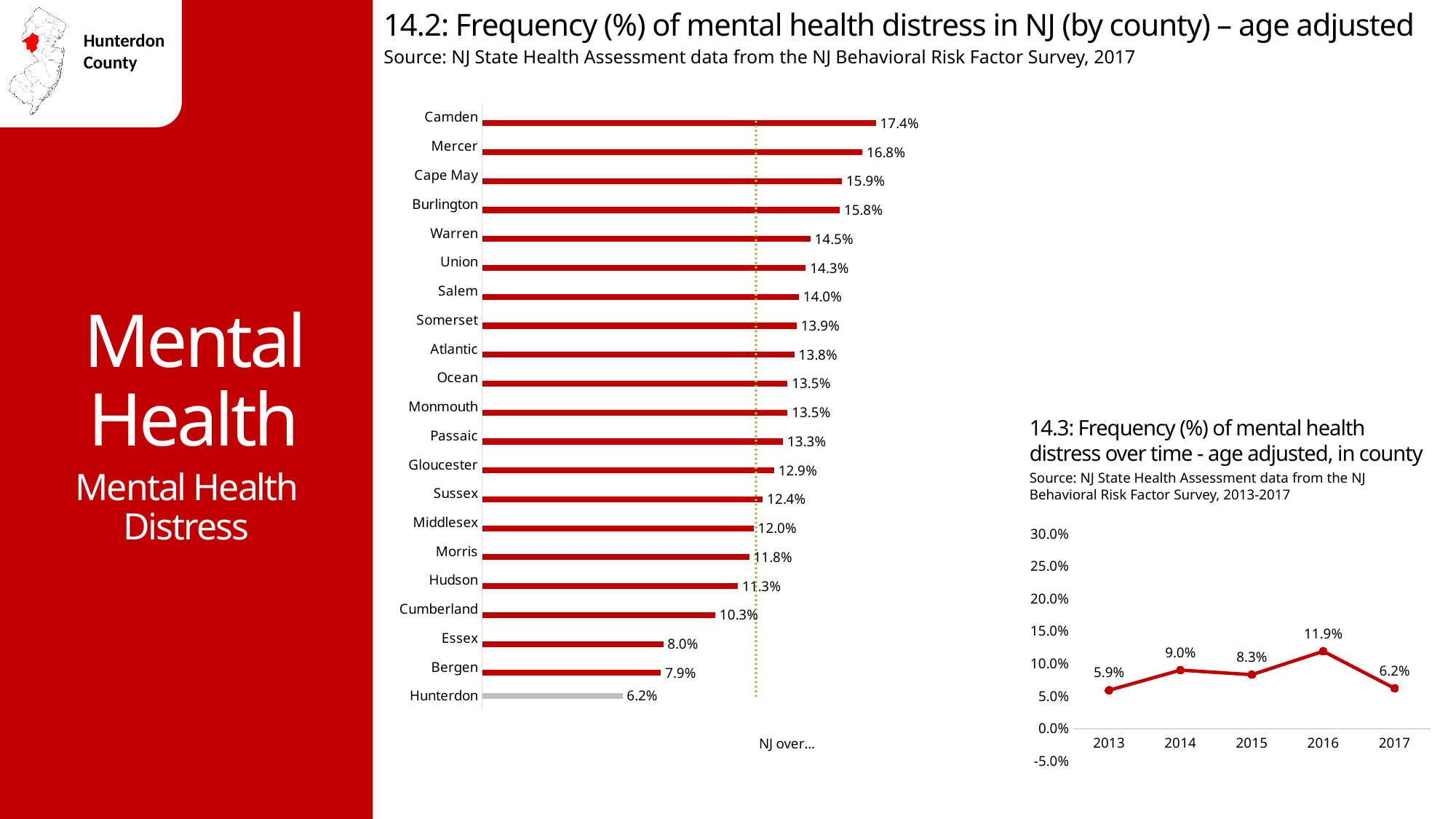
What kind of chart is chart 14.3 (mental health distress over time)? Line chart In chart 14.2 (mental health distress by county), which county has the lowest value? Hunterdon In chart 14.3 (mental health distress over time), which year has the highest value? 2016 What kind of chart is chart 14.2 (mental health distress by county)? Bar chart In chart 14.2 (mental health distress by county), which is larger, the value for Warren or the value for Sussex? Warren In chart 14.2 (mental health distress by county), what is the value for Hunterdon? 6.2% In chart 14.2 (mental health distress by county), which county has the highest value? Camden In chart 14.3 (mental health distress over time), what is the difference between 2016 and 2017? 5.7% In chart 14.2 (mental health distress by county), how many counties are shown? 21 In chart 14.2 (mental health distress by county), what is the difference between Mercer and Bergen? 8.9% In chart 14.2 (mental health distress by county), what is the value for Camden? 17.4% In chart 14.3 (mental health distress over time), what is the value for 2016? 11.9%